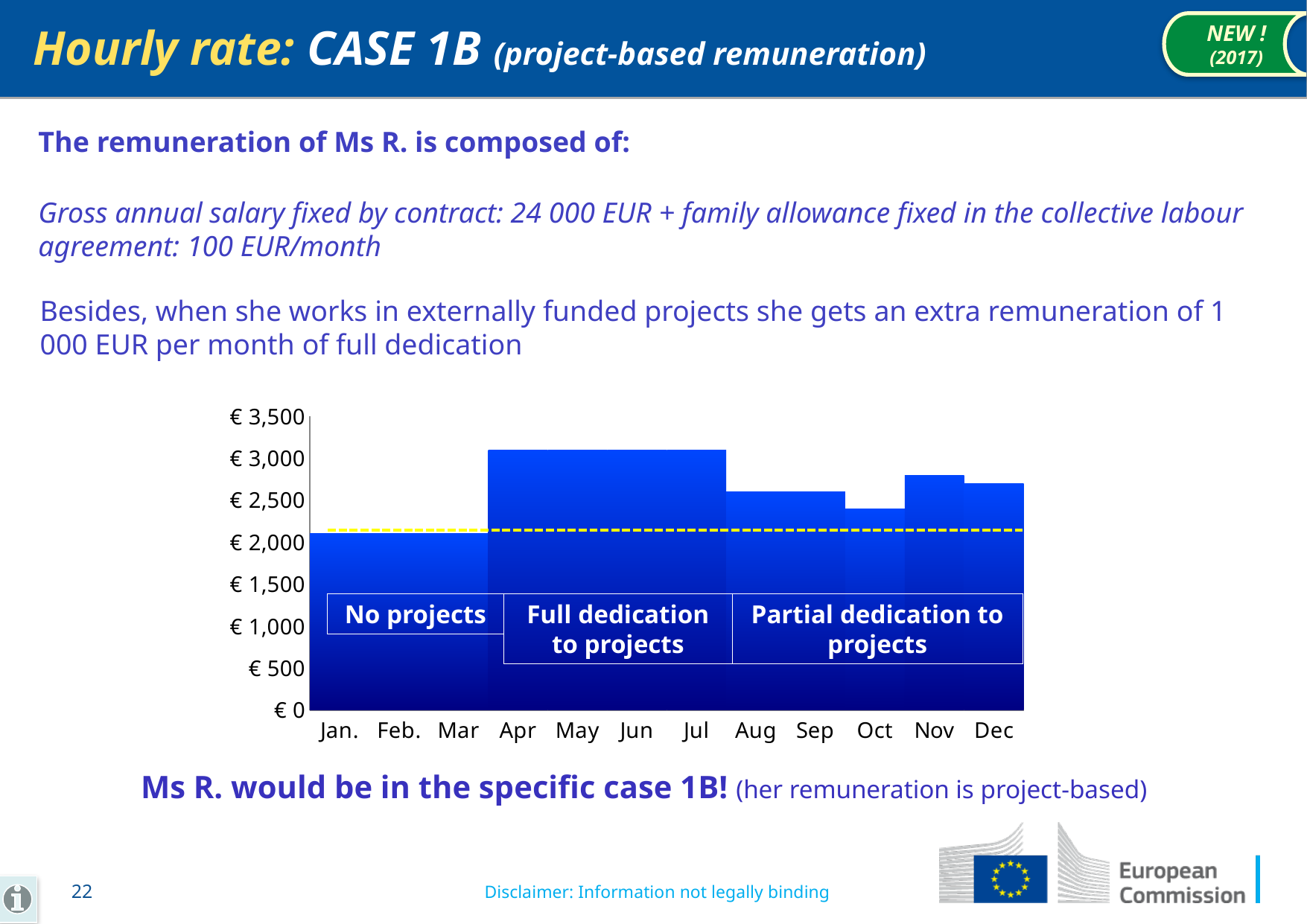
Which is larger, the value for Jul or the value for Dec? Jul What label is shown over the Aug to Dec bars in the chart? Partial dedication to projects Is the value for Mar greater or less than € 3,000? less Do the values rise or fall from Mar to Apr? rise What label is shown over the Jan. to Mar bars in the chart? No projects How many months are shown along the x axis of the chart? 12 Is the value for Jan. greater or less than € 2,500? less Is the value for Apr greater or less than € 2,500? greater What kind of chart is shown on the slide? bar chart Which is larger, the value for Jun or the value for Feb.? Jun